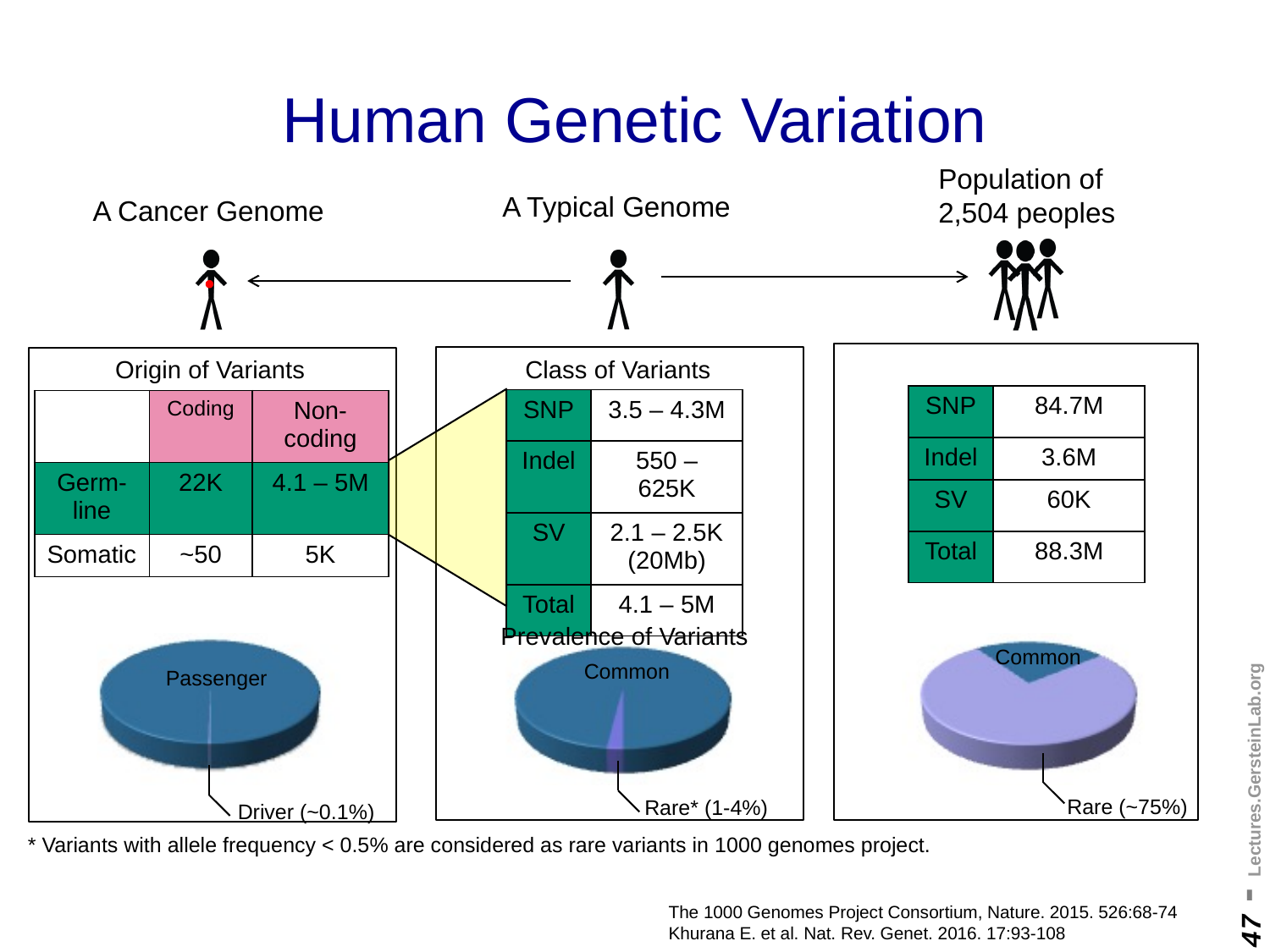
In the pie chart under 'A Cancer Genome', which slice is the smallest? Driver In the pie chart under 'Population of 2,504 peoples', which slice is smaller, Common or Rare? Common In the 'Prevalence of Variants' pie chart under 'A Typical Genome', which slice is larger, Common or Rare? Common In the pie chart under 'Population of 2,504 peoples', what percentage is printed next to the Rare slice? ~75% In the pie chart under 'Population of 2,504 peoples', is the Rare slice greater or less than 50% of the pie? greater In the pie chart under 'A Cancer Genome', how many slices are there? 2 In the pie chart under 'A Cancer Genome', which slice is larger, Passenger or Driver? Passenger In the pie chart under 'Population of 2,504 peoples', which slice is the largest? Rare In the pie chart under 'A Cancer Genome', what percentage is printed next to the Driver slice? ~0.1% What kind of chart is used in the bottom row of the slide (e.g., under 'A Cancer Genome')? pie chart In the 'Prevalence of Variants' pie chart under 'A Typical Genome', what range is printed next to the Rare slice? 1-4% How many pie charts are shown on the slide? 3